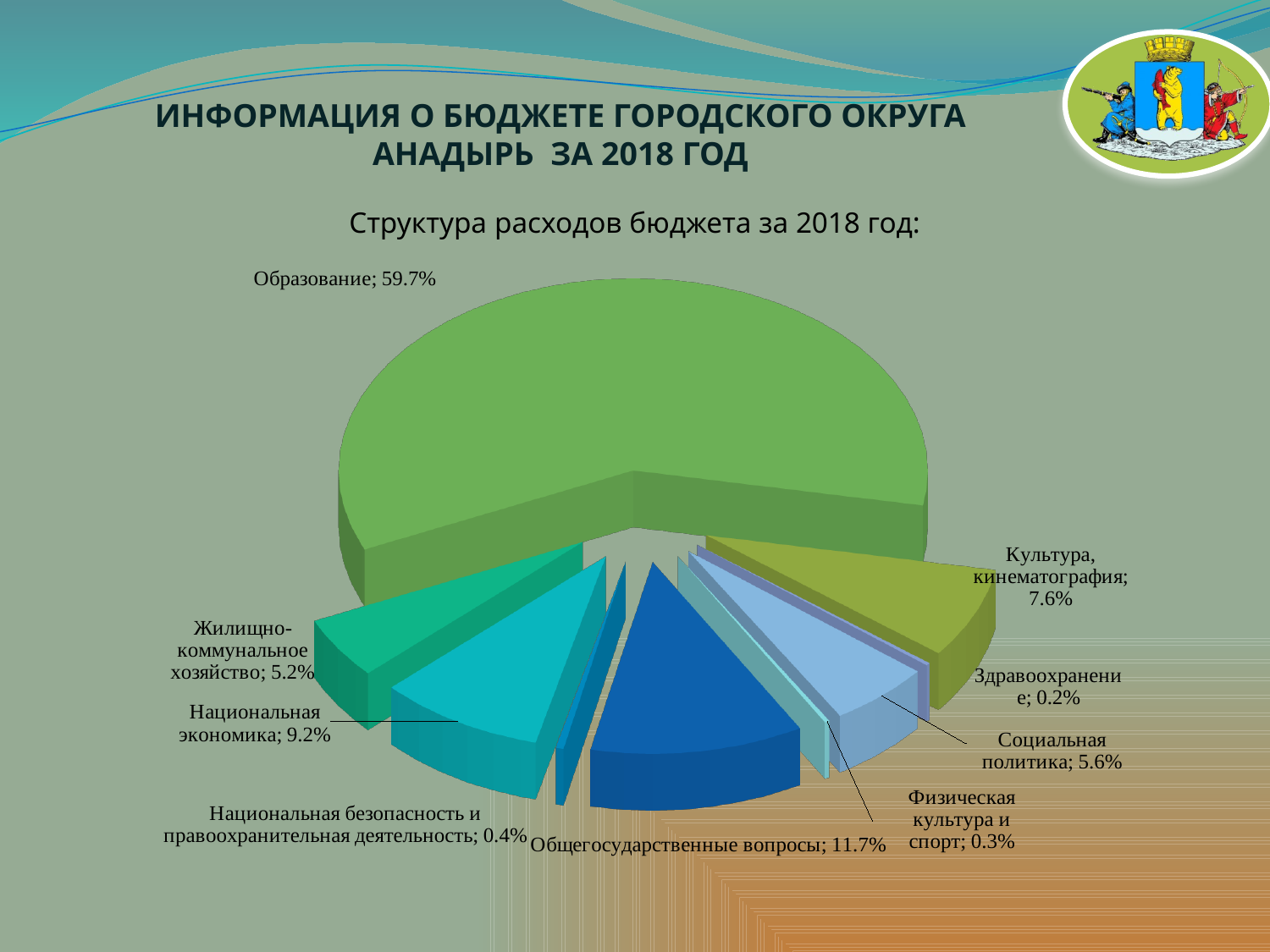
How many categories are shown in the pie chart? 9 What is the value shown for Физическая культура и спорт? 0.3% Which category has the smallest share of the pie? Здравоохранение Which category has the largest share of the pie? Образование What is the value shown for Национальная экономика? 9.2% What type of chart is shown on the slide? Pie chart What is the value shown for Здравоохранение? 0.2% What is the difference between the shares of Культура, кинематография and Социальная политика? 2.0% What is the value shown for Общегосударственные вопросы? 11.7% What is the title of the chart? Структура расходов бюджета за 2018 год: Which is larger: the share for Национальная экономика or the share for Жилищно-коммунальное хозяйство? Национальная экономика What share of the budget expenditure goes to Образование? 59.7%